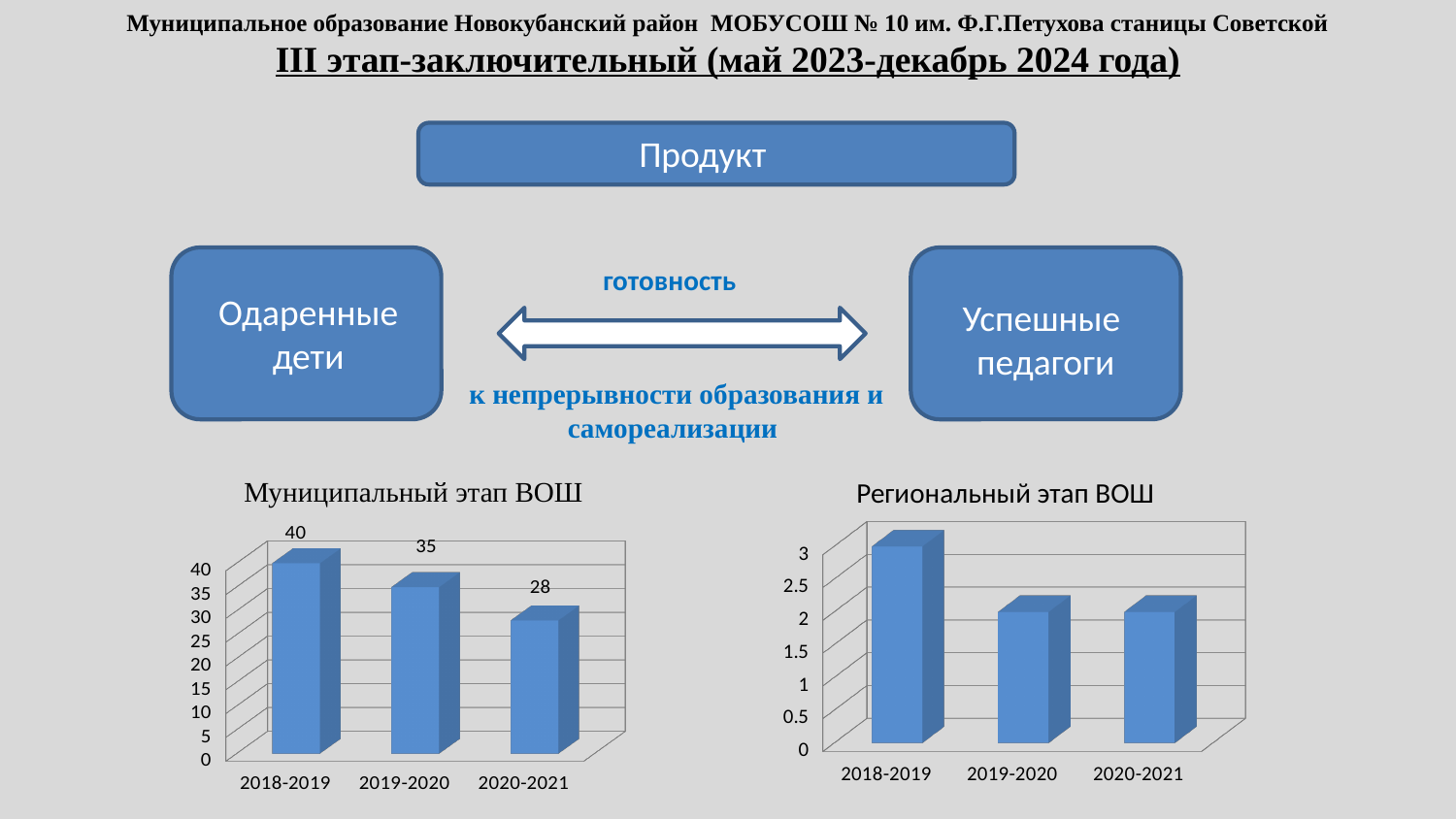
In the 'Муниципальный этап ВОШ' chart, what is the difference between the values for 2018-2019 and 2020-2021? 12 In the 'Региональный этап ВОШ' chart, which year has the highest value? 2018-2019 In the 'Региональный этап ВОШ' chart, is the value for 2018-2019 greater or less than 2.5? greater In the 'Муниципальный этап ВОШ' chart, what is the value for 2018-2019? 40 In the 'Муниципальный этап ВОШ' chart, which year has the highest value? 2018-2019 In the 'Муниципальный этап ВОШ' chart, do the values rise or fall from 2018-2019 to 2020-2021? fall In the 'Муниципальный этап ВОШ' chart, what is the value for 2020-2021? 28 What type of chart is the 'Региональный этап ВОШ' chart? bar chart What is the title of the chart on the left side of the slide? Муниципальный этап ВОШ In the 'Муниципальный этап ВОШ' chart, how many categories are shown on the x axis? 3 In the 'Региональный этап ВОШ' chart, is the value for 2019-2020 greater or less than 2.5? less In the 'Муниципальный этап ВОШ' chart, which year has the lowest value? 2020-2021